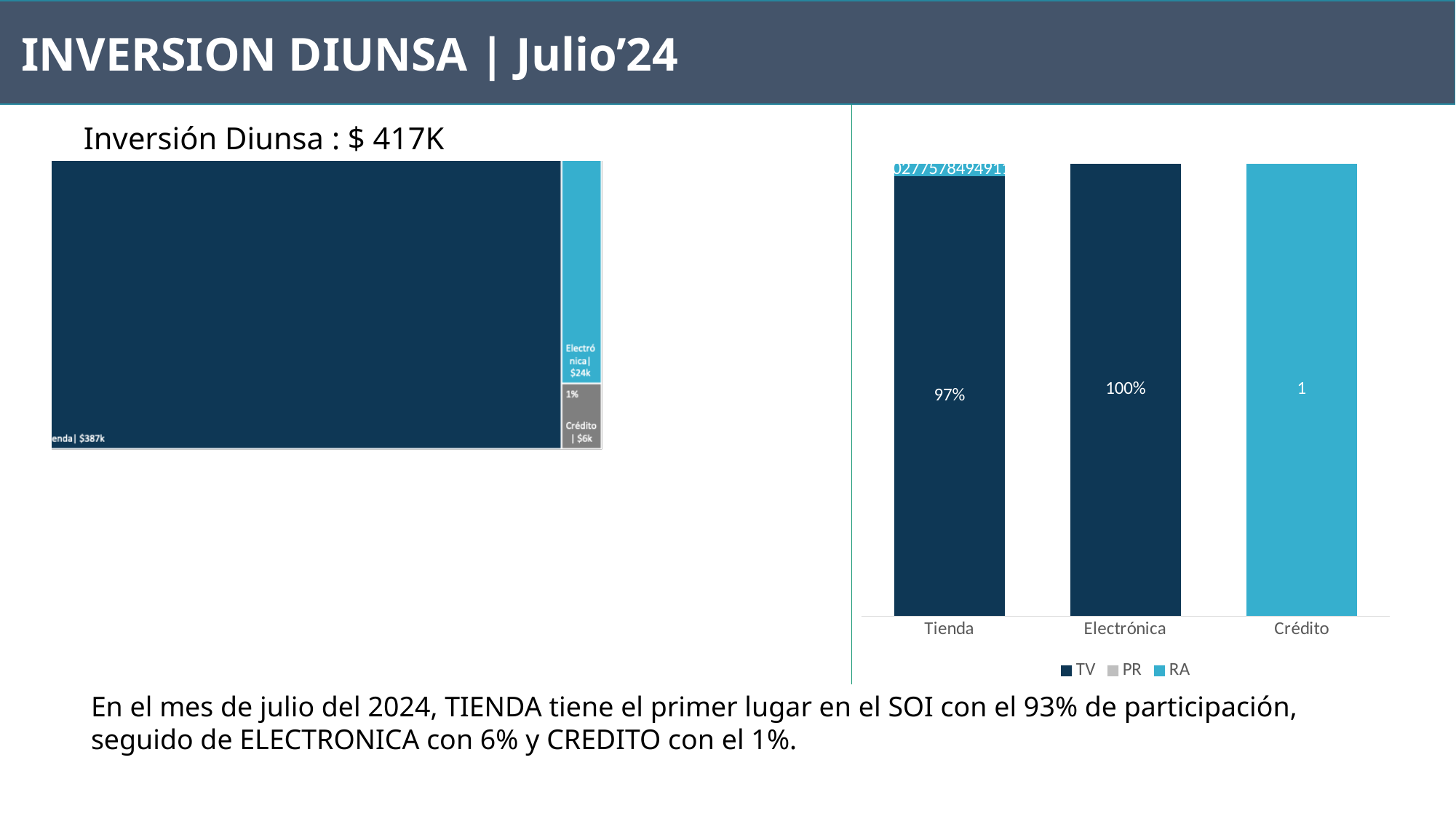
In the treemap on the left, what value is shown for Crédito? $6k What kind of chart is shown on the right side of the slide? Stacked bar chart In the bar chart on the right, what value is labelled on the Crédito bar? 1 In the bar chart on the right, what are the legend entries? TV, PR, RA In the treemap on the left, what value is shown for Electrónica? $24k In the bar chart on the right, what is the value labelled on the Electrónica bar? 100% In the treemap on the left, which category occupies the largest area? Tienda In the bar chart on the right, which has the higher TV percentage, Tienda or Electrónica? Electrónica In the bar chart on the right, how many series does the legend list? 3 In the treemap on the left, what value is shown for Tienda? $387k In the bar chart on the right, how many categories are shown on the x axis? 3 In the bar chart on the right, what is the value labelled on the Tienda bar for TV? 97%